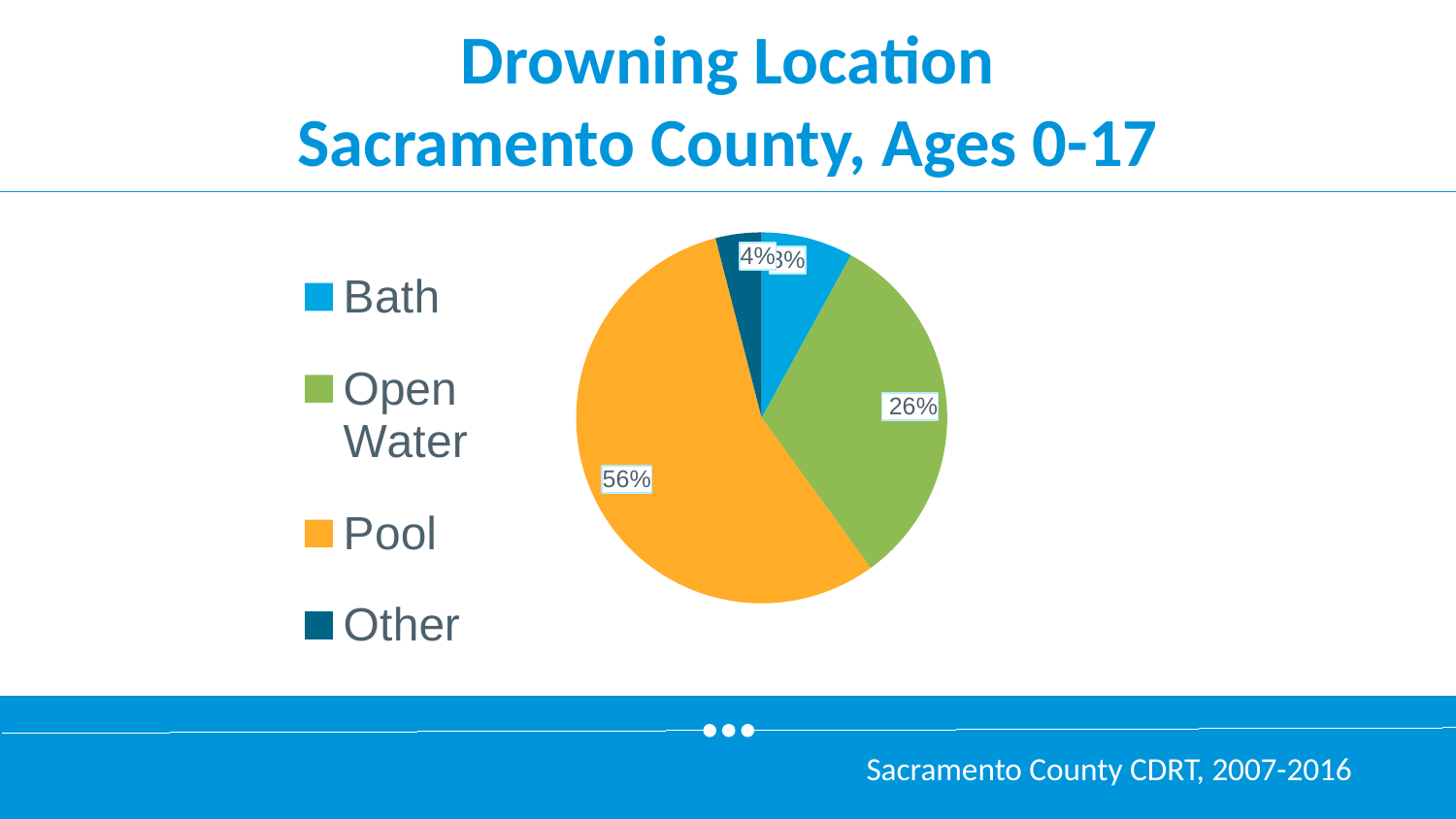
What percentage of drownings occurred in a pool? 56% What colour represents Pool in the pie chart? Orange How many percentage points larger is the Pool share than the Open Water share? 30 percentage points What percentage of drownings occurred in open water? 26% What is the title of the chart? Drowning Location Sacramento County, Ages 0-17 Which is larger, the share for Pool or the share for Open Water? Pool Is the share for Pool greater or less than 50%? greater What type of chart is shown on the slide? Pie chart Which drowning location has the smallest share of the pie? Other How many drowning location categories are shown in the pie chart? 4 Which drowning location has the largest share of the pie? Pool